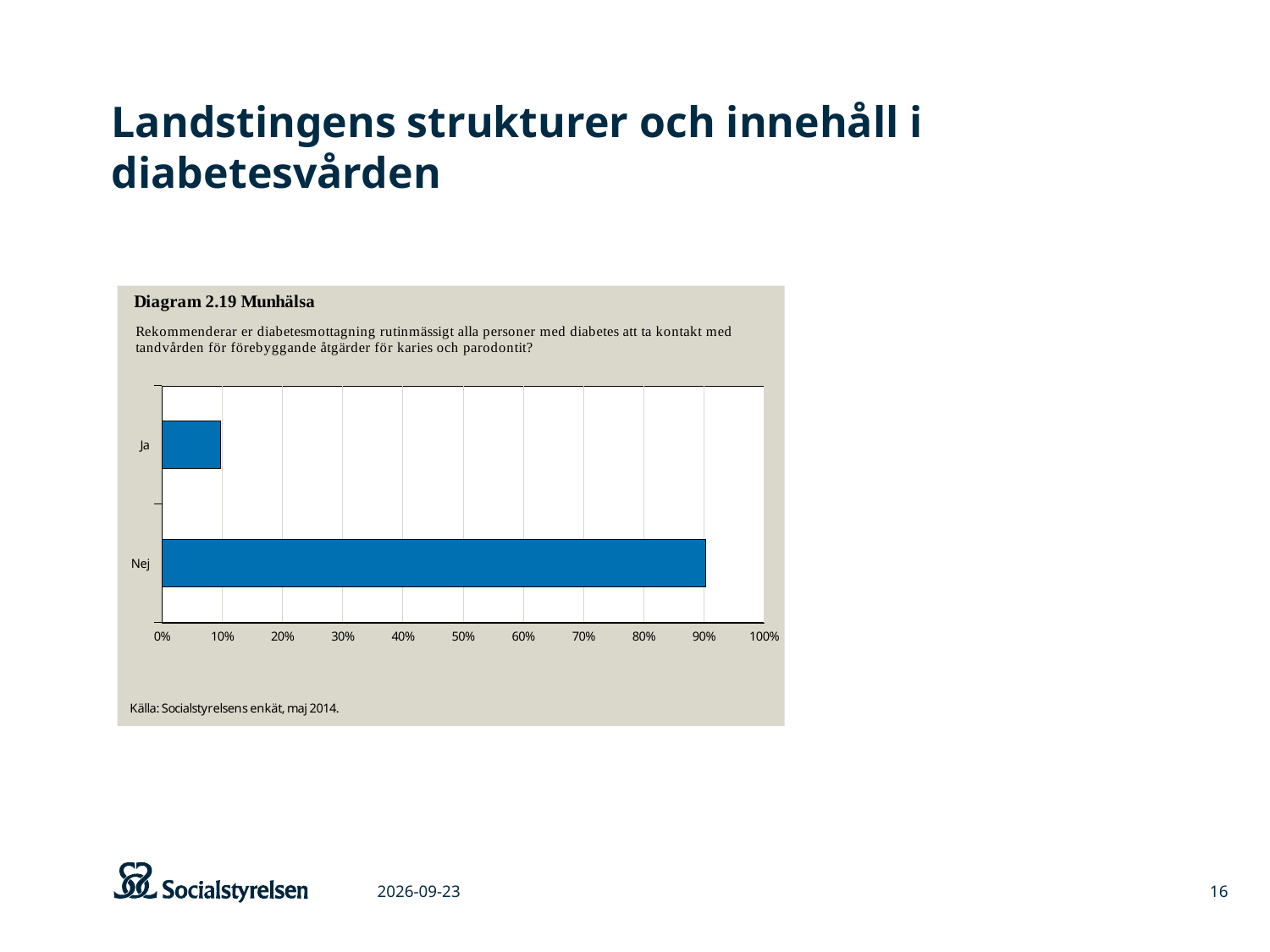
What kind of chart is shown in Diagram 2.19 Munhälsa? bar chart Is the value for Nej greater or less than 50%? greater What source is cited below the chart? Socialstyrelsens enkät, maj 2014. What is the title of the diagram on the slide? Diagram 2.19 Munhälsa Is the value for Nej greater or less than 80%? greater Is the value for Ja greater or less than 20%? less Which category has the lowest value in the chart? Ja How many categories are plotted in the chart? 2 Which category has the highest value in the chart? Nej Which is larger, the value for Ja or the value for Nej? Nej